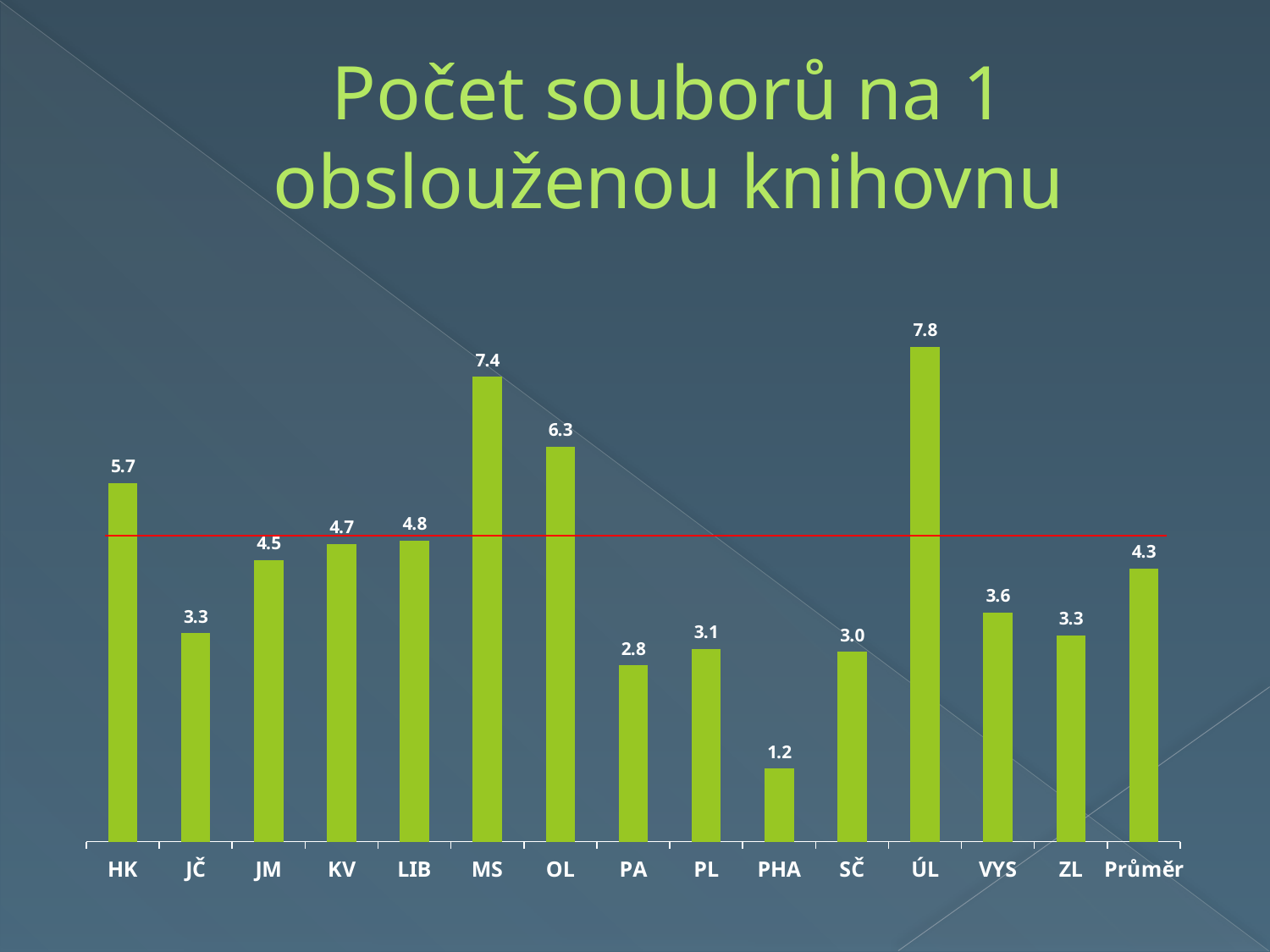
What is the title of the chart? Počet souborů na 1 obslouženou knihovnu Which is larger, the value for OL or the value for HK? OL Which is larger, the value for VYS or the value for PA? VYS What is the difference between the values for HK and JČ? 2.4 Which category has the lowest value? PHA What is the value for MS? 7.4 What kind of chart is shown on the slide? bar chart Which category has the highest value? ÚL What is the difference between the values for ÚL and MS? 0.4 What is the value for PHA? 1.2 How many categories are shown on the x axis? 15 What is the value for Průměr? 4.3